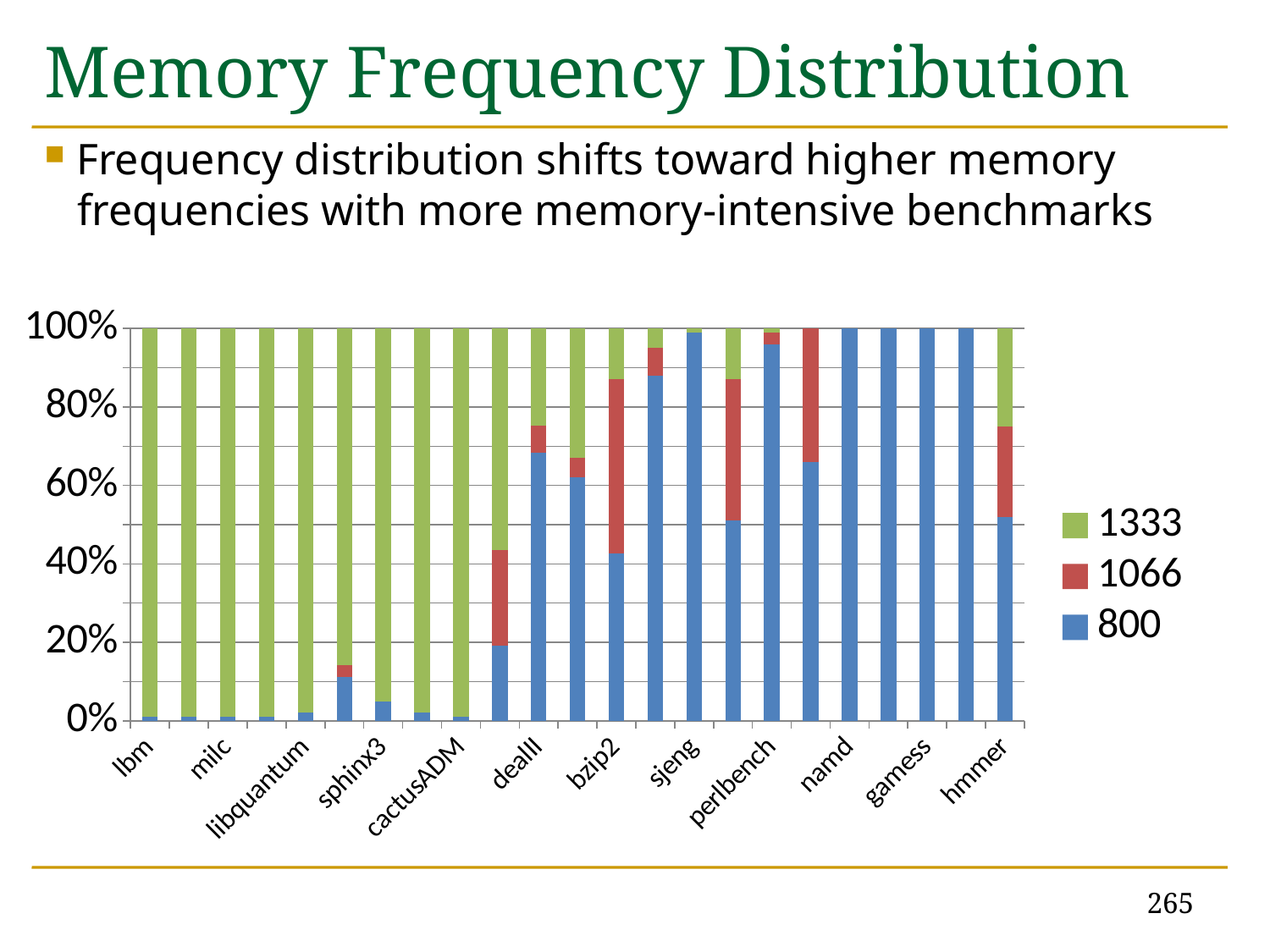
What kind of chart is shown on the slide? stacked bar chart What is the title of the slide containing the chart? Memory Frequency Distribution Is the 800 share for dealII greater or less than 60%? greater Is the 800 share for sphinx3 greater or less than 20%? less Is the 800 share for lbm greater or less than 20%? less Which series is shown in green in the legend? 1333 How many series does the legend list? 3 Does the 800 share generally rise or fall moving from left to right along the x axis? rise Which benchmark has the larger 800 share, lbm or namd? namd